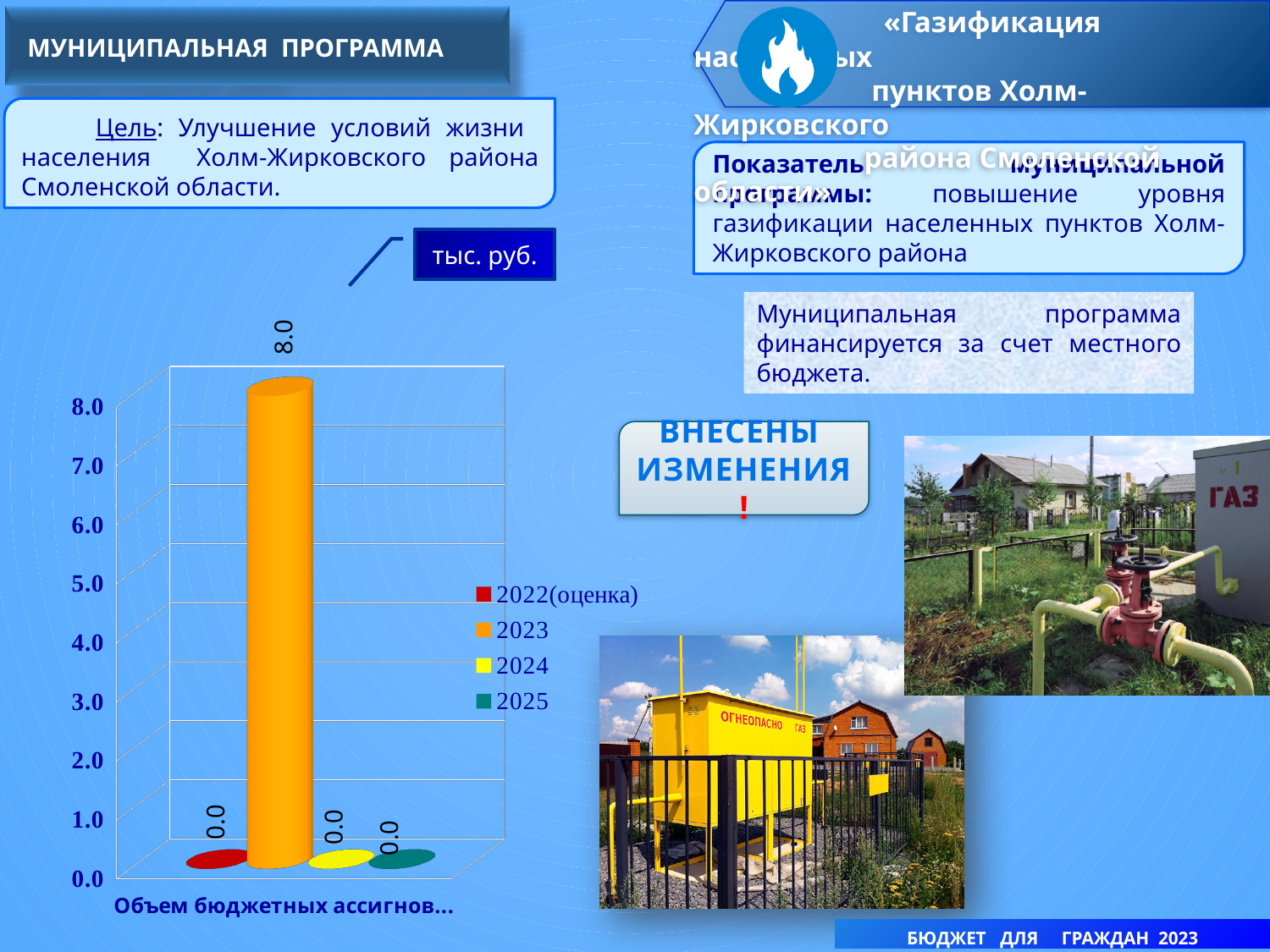
Which series has the highest value on the chart? 2023 Which is larger, the value for 2023 or the value for 2025? 2023 What kind of chart is shown on the slide? bar chart What colour is the bar for 2023? orange What is the value for 2023 on the chart? 8.0 What is the value for 2024 on the chart? 0.0 What is the value for 2025 on the chart? 0.0 Is the value for 2023 greater or less than 5.0? greater What unit is indicated for the chart values? тыс. руб. What is the value for 2022(оценка) on the chart? 0.0 What is the difference between the values for 2023 and 2024? 8.0 How many series does the chart legend list? 4